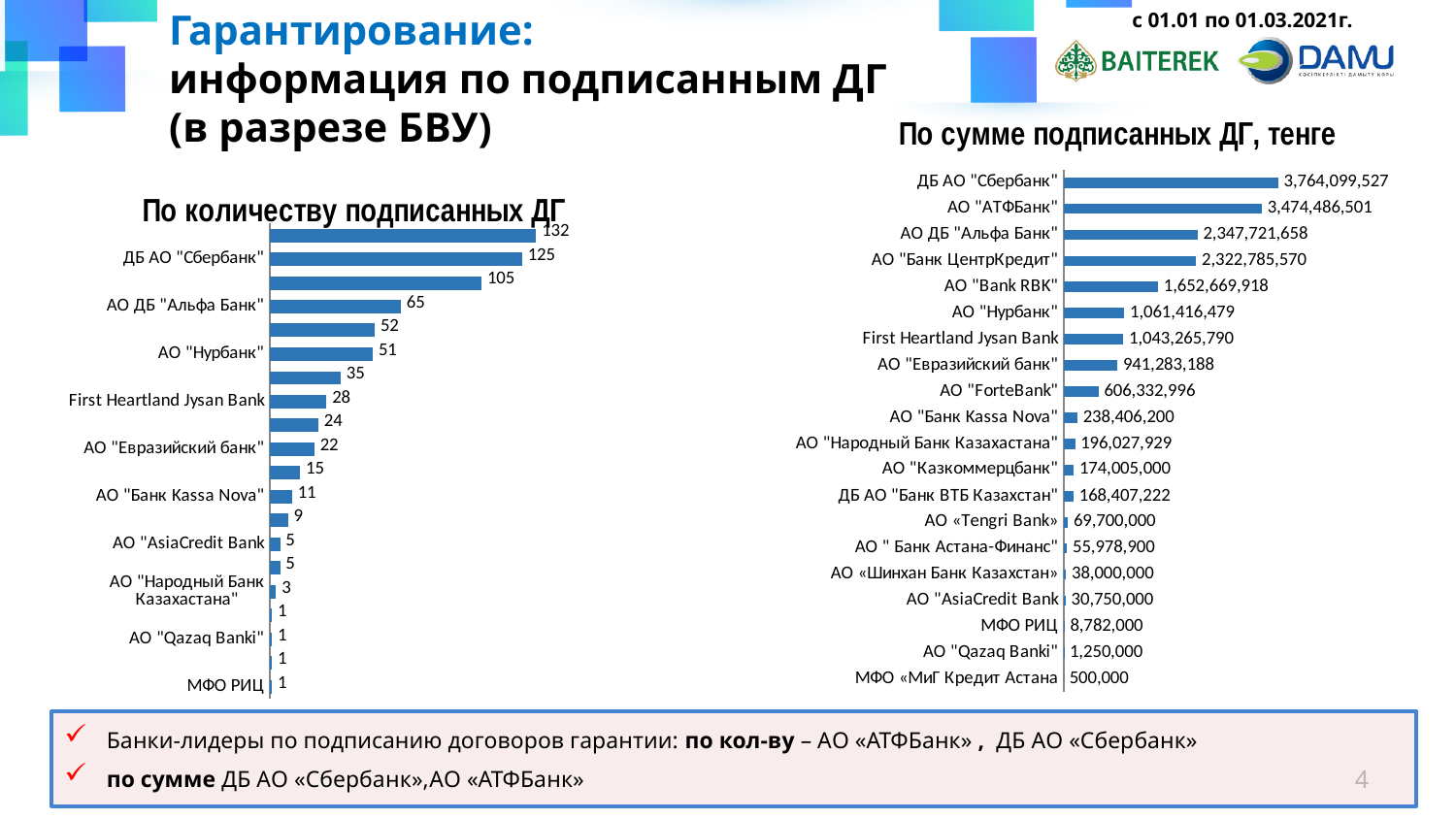
In the chart "По количеству подписанных ДГ", what is the value for ДБ АО "Сбербанк"? 125 In the chart "По сумме подписанных ДГ, тенге", which category has the lowest value? МФО «МиГ Кредит Астана» How many bars are shown in the chart "По сумме подписанных ДГ, тенге"? 20 In the chart "По сумме подписанных ДГ, тенге", which is larger: the value for АО "Банк Kassa Nova" or АО "Казкоммерцбанк"? АО "Банк Kassa Nova" In the chart "По количеству подписанных ДГ", what is the difference between the values for ДБ АО "Сбербанк" and АО "Нурбанк"? 74 In the chart "По сумме подписанных ДГ, тенге", what is the difference between the values for ДБ АО "Сбербанк" and АО "АТФБанк"? 289,613,026 What kind of chart is the chart titled "По сумме подписанных ДГ, тенге"? bar chart In the chart "По сумме подписанных ДГ, тенге", what is the value for АО "Bank RBK"? 1,652,669,918 In the chart "По количеству подписанных ДГ", what is the value for АО ДБ "Альфа Банк"? 65 In the chart "По сумме подписанных ДГ, тенге", which bank has the highest value? ДБ АО "Сбербанк" What kind of chart is the chart titled "По количеству подписанных ДГ"? bar chart In the chart "По сумме подписанных ДГ, тенге", what is the value for АО "ForteBank"? 606,332,996